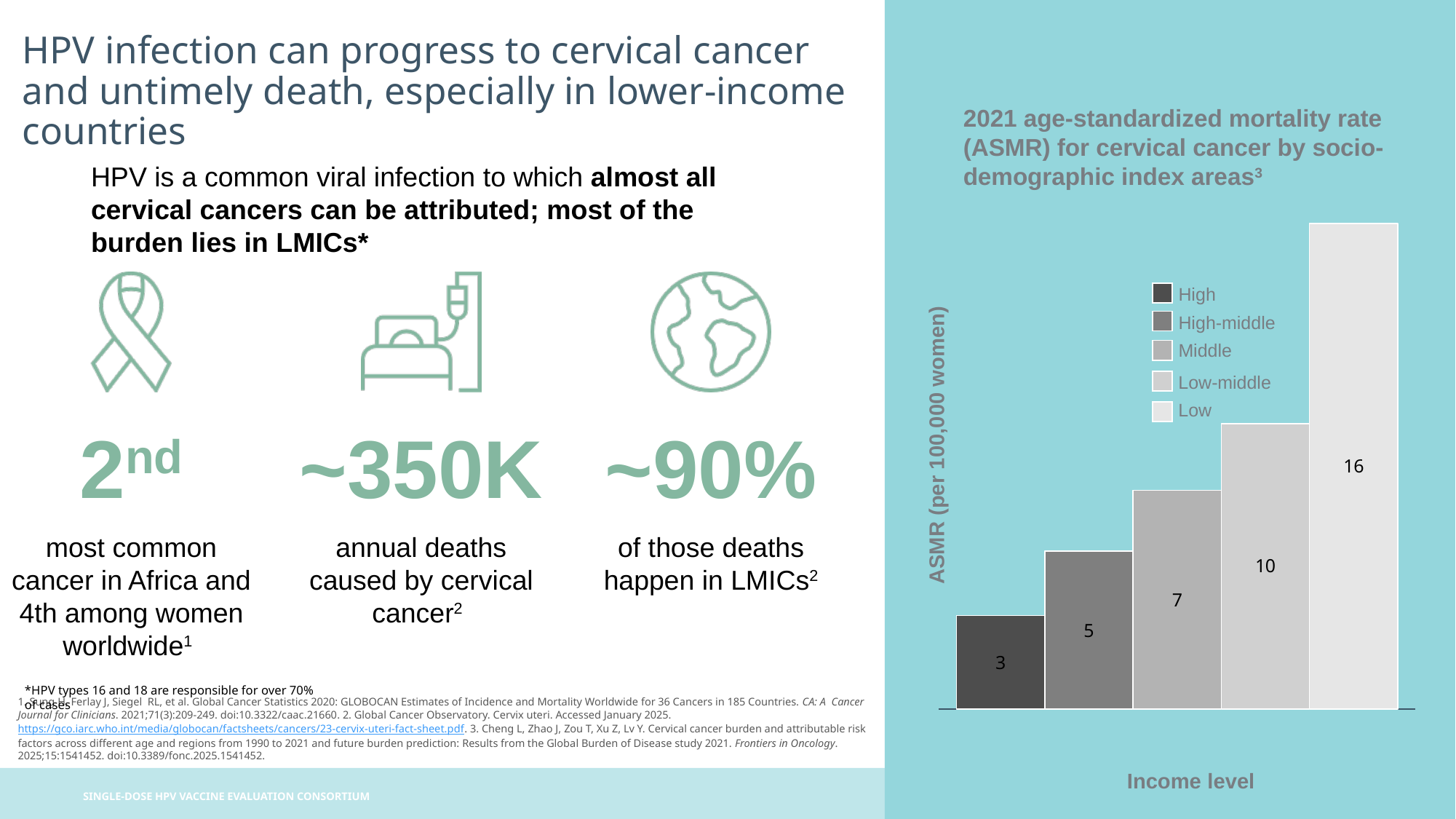
What is the difference in ASMR between the Low and High income levels? 13 What type of chart is shown on the slide? Bar chart How many income levels are shown in the chart? 5 Which income level has the highest ASMR? Low Which has a higher ASMR, Middle or High-middle? Middle Do the ASMR values rise or fall as the income level goes from High to Low along the x axis? Rise Which income level has the lowest ASMR? High What is the ASMR value for the Low-middle income level? 10 What is the ASMR value for the Middle income level? 7 What is the difference in ASMR between the Low-middle and High-middle income levels? 5 What is the ASMR value for the High income level? 3 How many entries does the legend list? 5